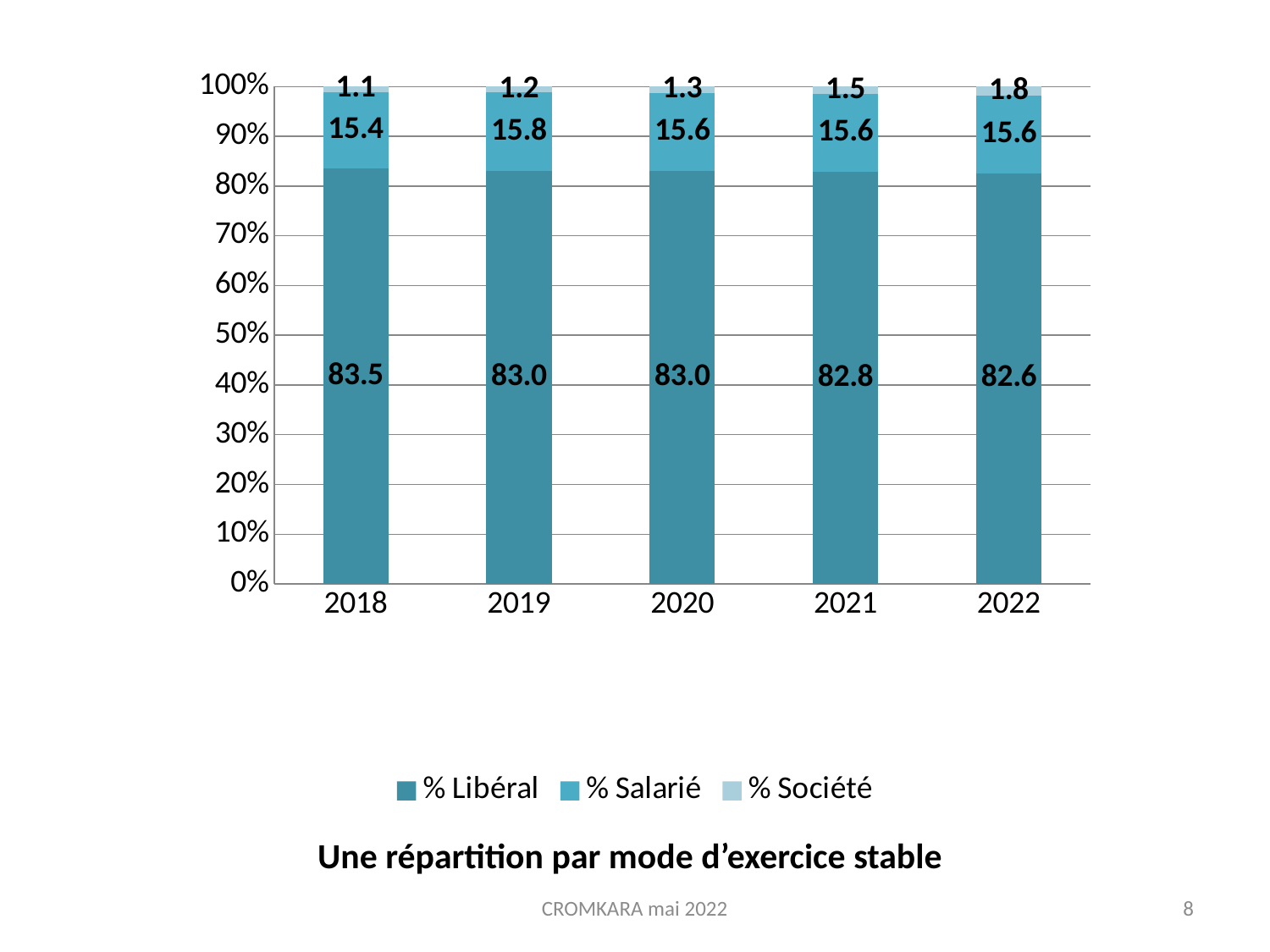
What is the value for % Libéral in 2018? 83.5 What is the difference between the % Libéral values for 2018 and 2022? 0.9 How many years are shown on the x axis? 5 Which year has the lowest value for % Libéral? 2022 How many series does the legend list? 3 Which year has the highest value for % Société? 2022 What is the value for % Salarié in 2019? 15.8 Does the % Société value rise or fall from 2018 to 2022? Rise Which is larger, the % Salarié value for 2018 or for 2019? 2019 What is the value for % Libéral in 2021? 82.8 What kind of chart is shown on the slide? Stacked bar chart What is the value for % Société in 2022? 1.8